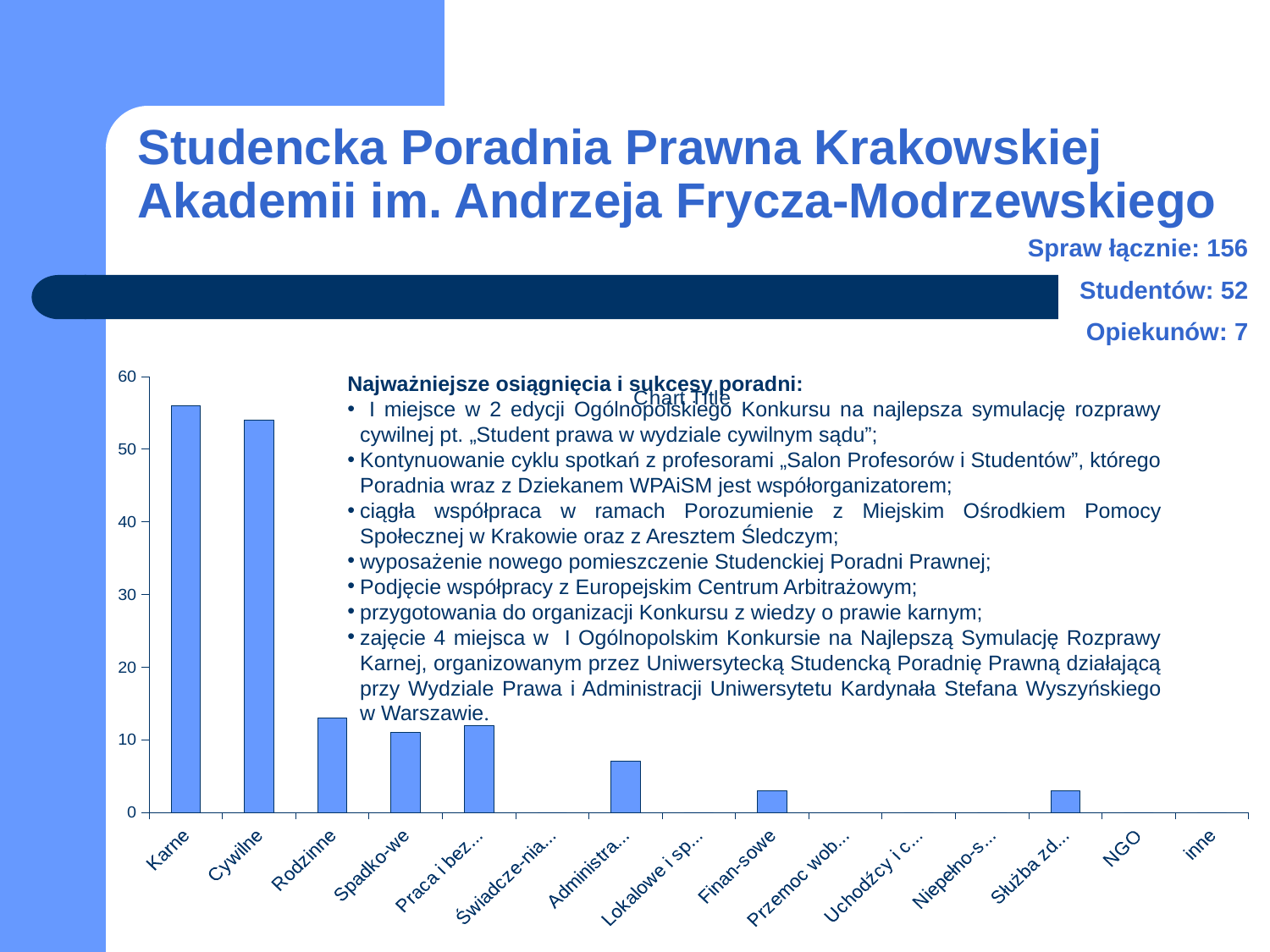
What kind of chart is shown on the slide? bar chart Is the value for Finan-sowe greater or less than 10? less Is the value for Administra... greater or less than 10? less Which is larger, the value for Rodzinne or the value for Finan-sowe? Rodzinne Is the value for Rodzinne greater or less than 20? less What is the title shown on the chart? Chart Title Which is larger, the value for Karne or the value for Cywilne? Karne How many categories are shown on the x axis of the chart? 15 Which is larger, the value for Cywilne or the value for Rodzinne? Cywilne Which category has the highest bar in the chart? Karne